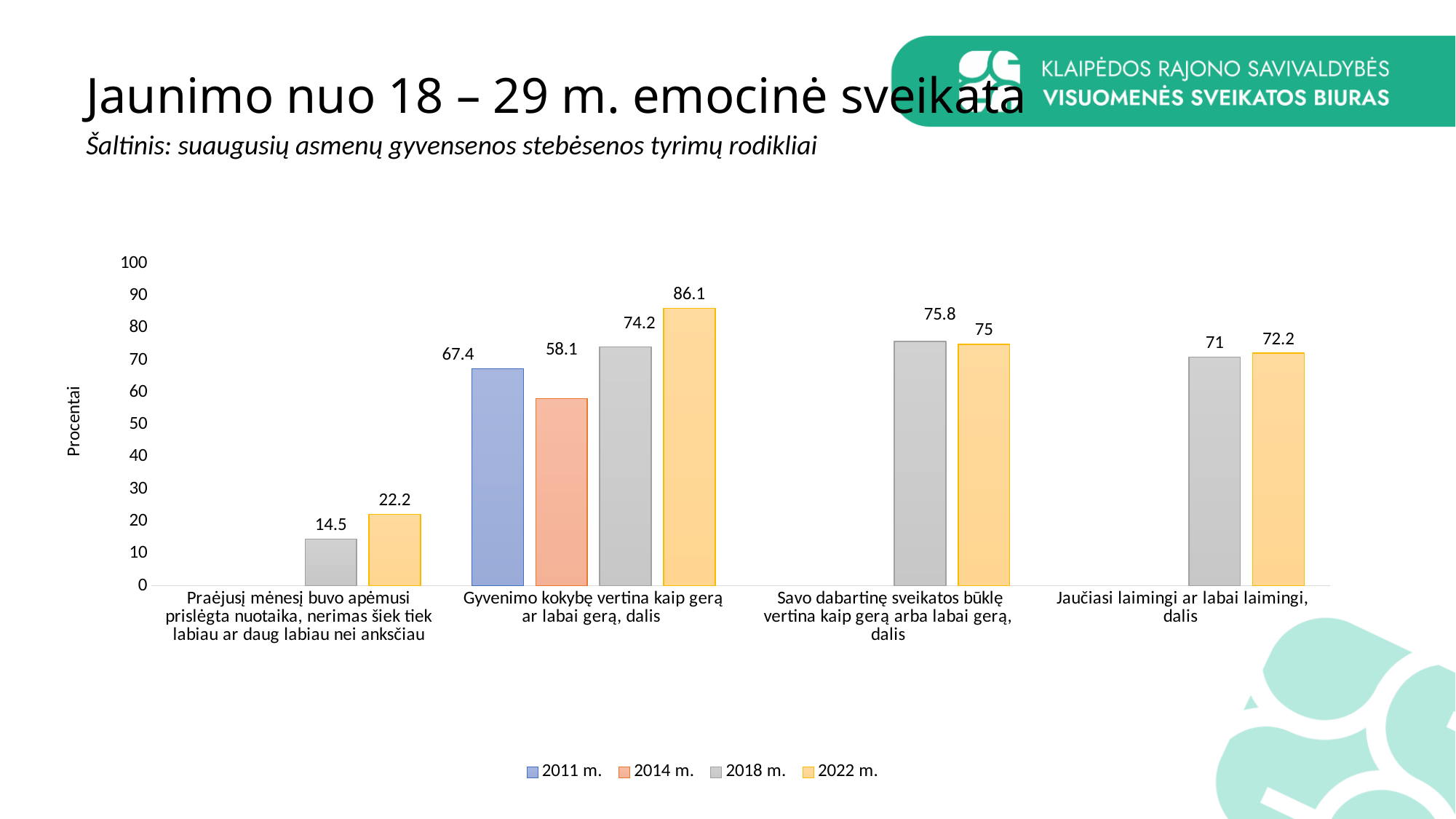
How many categories are shown on the x axis? 4 What type of chart is shown on the slide? bar chart What is the 2022 m. value for "Gyvenimo kokybę vertina kaip gerą ar labai gerą, dalis"? 86.1 For "Savo dabartinę sveikatos būklę vertina kaip gerą arba labai gerą, dalis", which is larger: the 2018 m. value or the 2022 m. value? 2018 m. How many series does the legend list? 4 What is the label of the vertical axis? Procentai What is the 2014 m. value for "Gyvenimo kokybę vertina kaip gerą ar labai gerą, dalis"? 58.1 Which year has the highest value for "Gyvenimo kokybę vertina kaip gerą ar labai gerą, dalis"? 2022 m. Is the 2022 m. value for "Praėjusį mėnesį buvo apėmusi prislėgta nuotaika, nerimas šiek tiek labiau ar daug labiau nei anksčiau" greater or less than 20? greater Which year has the lowest value for "Gyvenimo kokybę vertina kaip gerą ar labai gerą, dalis"? 2014 m. What is the 2018 m. value for "Praėjusį mėnesį buvo apėmusi prislėgta nuotaika, nerimas šiek tiek labiau ar daug labiau nei anksčiau"? 14.5 What is the difference between the 2022 m. and 2018 m. values for "Jaučiasi laimingi ar labai laimingi, dalis"? 1.2